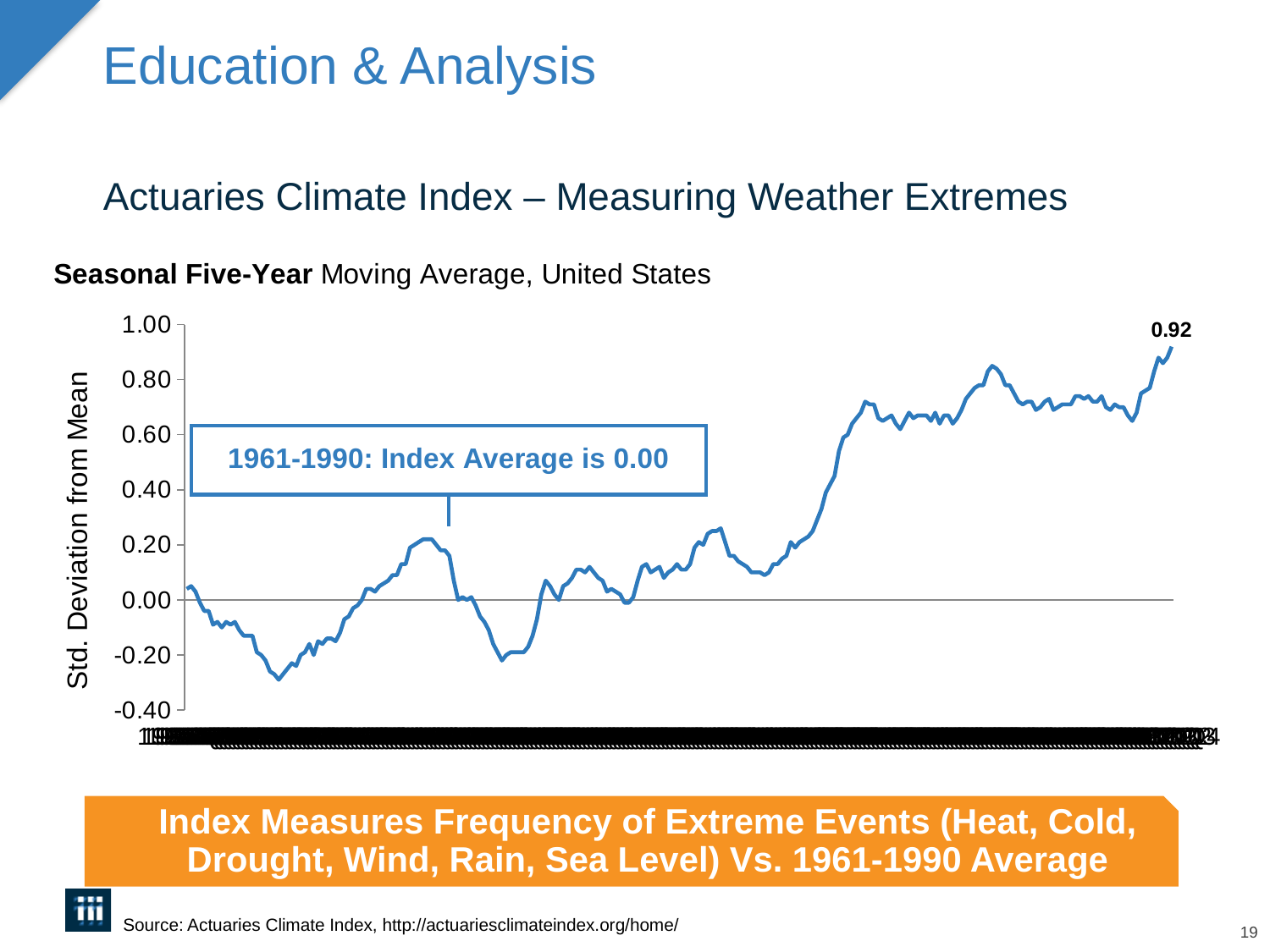
What is the highest tick value shown on the vertical axis? 1.00 Overall, does the line rise or fall from left to right across the chart? rise Is the lowest point of the line greater or less than -0.20? less What kind of chart is shown on the slide? line chart What is the value of the data label at the right end of the line? 0.92 What is the label on the vertical axis of the chart? Std. Deviation from Mean Is the final labelled value of the line greater or less than 0.80? greater According to the annotation box on the chart, what is the index average for 1961-1990? 0.00